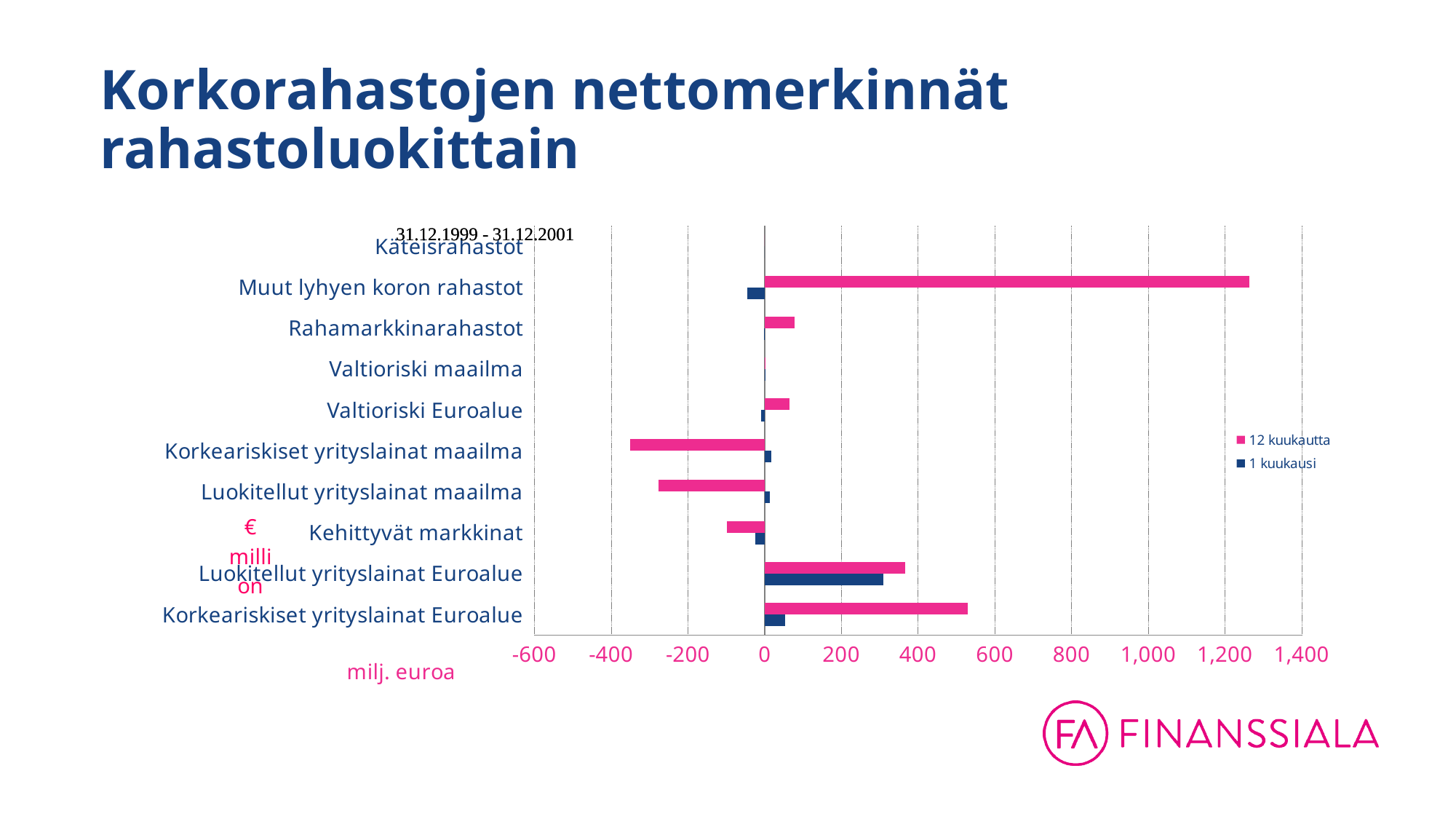
Is the 12 kuukautta value for Korkeariskiset yrityslainat Euroalue greater or less than 400? greater Is the 1 kuukausi value for Luokitellut yrityslainat Euroalue greater or less than 200? greater Which category has the highest value for the 12 kuukautta series? Muut lyhyen koron rahastot Which category has the lowest (most negative) value for the 12 kuukautta series? Korkeariskiset yrityslainat maailma For the 12 kuukautta series, which is larger: Korkeariskiset yrityslainat Euroalue or Luokitellut yrityslainat Euroalue? Korkeariskiset yrityslainat Euroalue What unit is shown below the horizontal axis? milj. euroa Which category has the highest value for the 1 kuukausi series? Luokitellut yrityslainat Euroalue Is the 12 kuukautta value for Muut lyhyen koron rahastot greater or less than 1,200? greater What kind of chart is shown on the slide? bar chart How many fund categories are listed on the vertical axis? 10 How many series does the legend list? 2